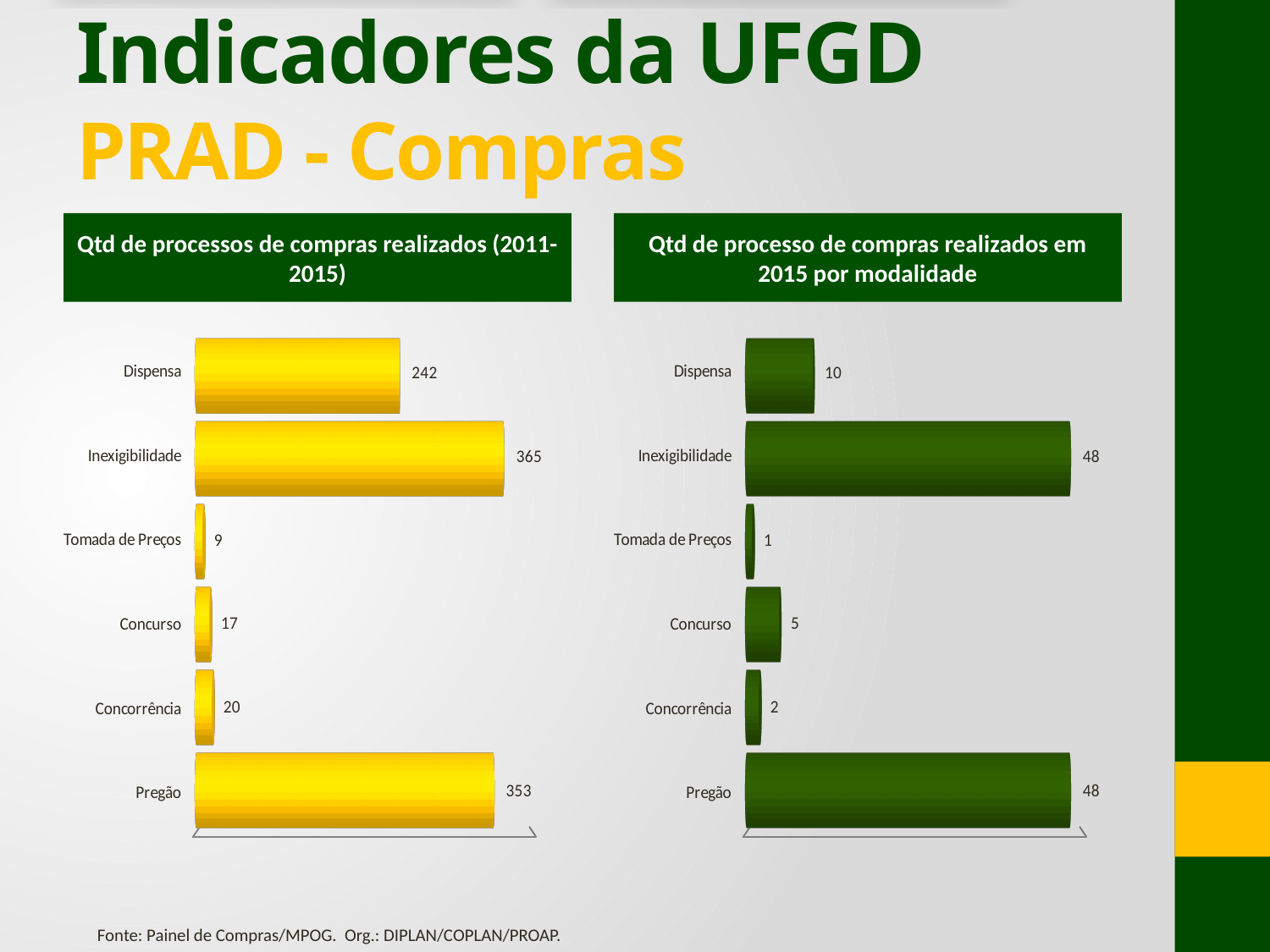
In the left chart (2011-2015), which category has the highest value? Inexigibilidade In the left chart (2011-2015), which is larger, Concorrência or Concurso? Concorrência In the left chart (2011-2015), what is the difference between Inexigibilidade and Pregão? 12 How many categories are shown in the right chart (2015 por modalidade)? 6 In the left chart (2011-2015), which category has the lowest value? Tomada de Preços In the right chart (2015 por modalidade), which category has the lowest value? Tomada de Preços In the left chart (2011-2015), what is the value for Pregão? 353 What type of chart is the left chart (2011-2015)? Bar chart In the left chart (2011-2015), what is the value for Inexigibilidade? 365 In the right chart (2015 por modalidade), what is the difference between Dispensa and Concurso? 5 In the right chart (2015 por modalidade), what is the value for Dispensa? 10 In the right chart (2015 por modalidade), what is the value for Concurso? 5